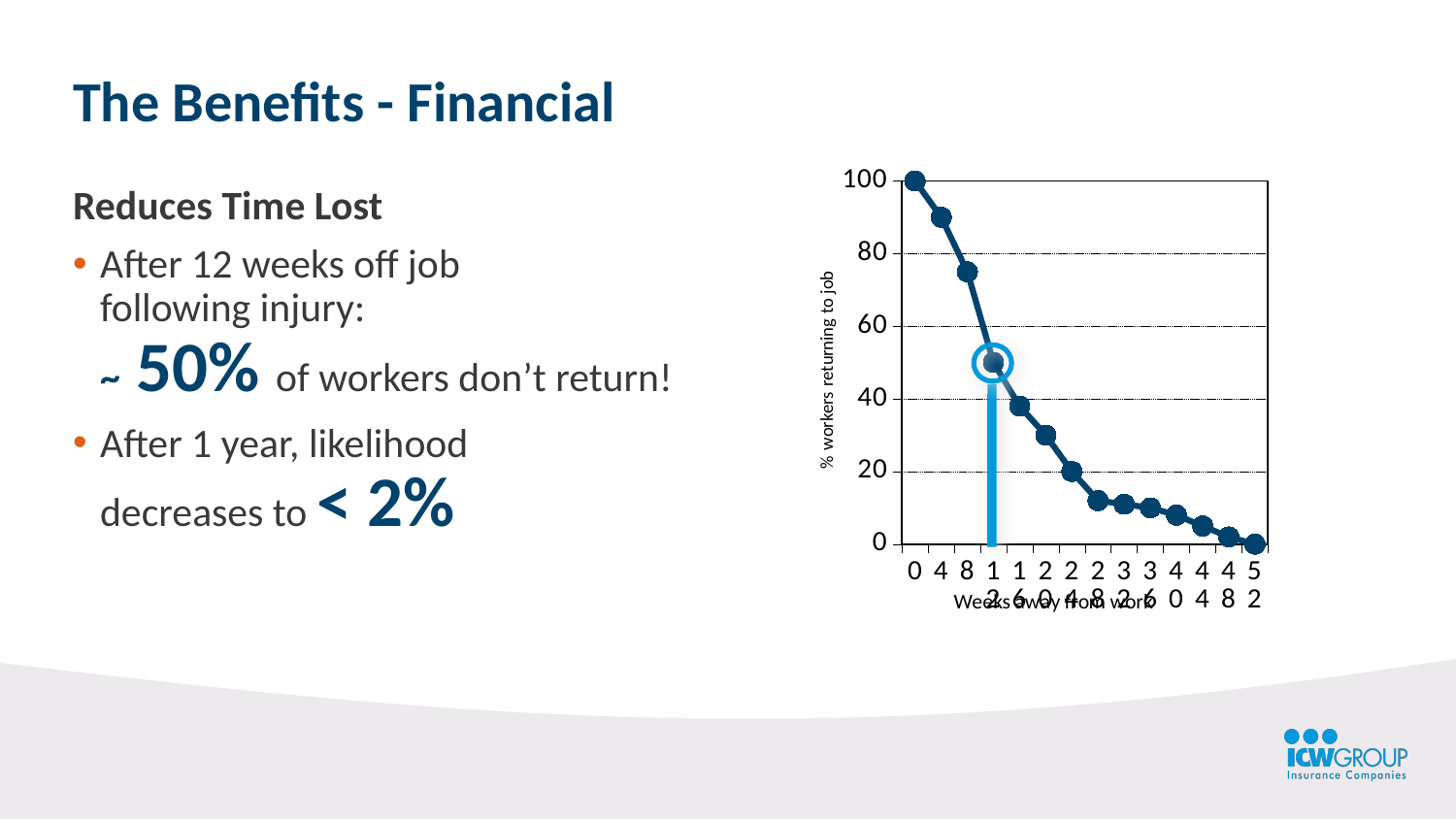
What kind of chart is shown on the slide? line chart How many data points are plotted on the line? 14 At how many weeks away from work is the percentage of workers returning to job highest? 0 At how many weeks away from work is the percentage of workers returning to job lowest? 52 What is the title of the horizontal axis of the chart? Weeks away from work Is the value at 20 weeks away from work greater or less than 40? less What is the percentage of workers returning to job at 0 weeks away from work? 100 Is the value at 8 weeks away from work greater or less than 60? greater What is the title of the vertical axis of the chart? % workers returning to job Is the value at 28 weeks away from work greater or less than 20? less Do the values rise or fall as weeks away from work increase? fall